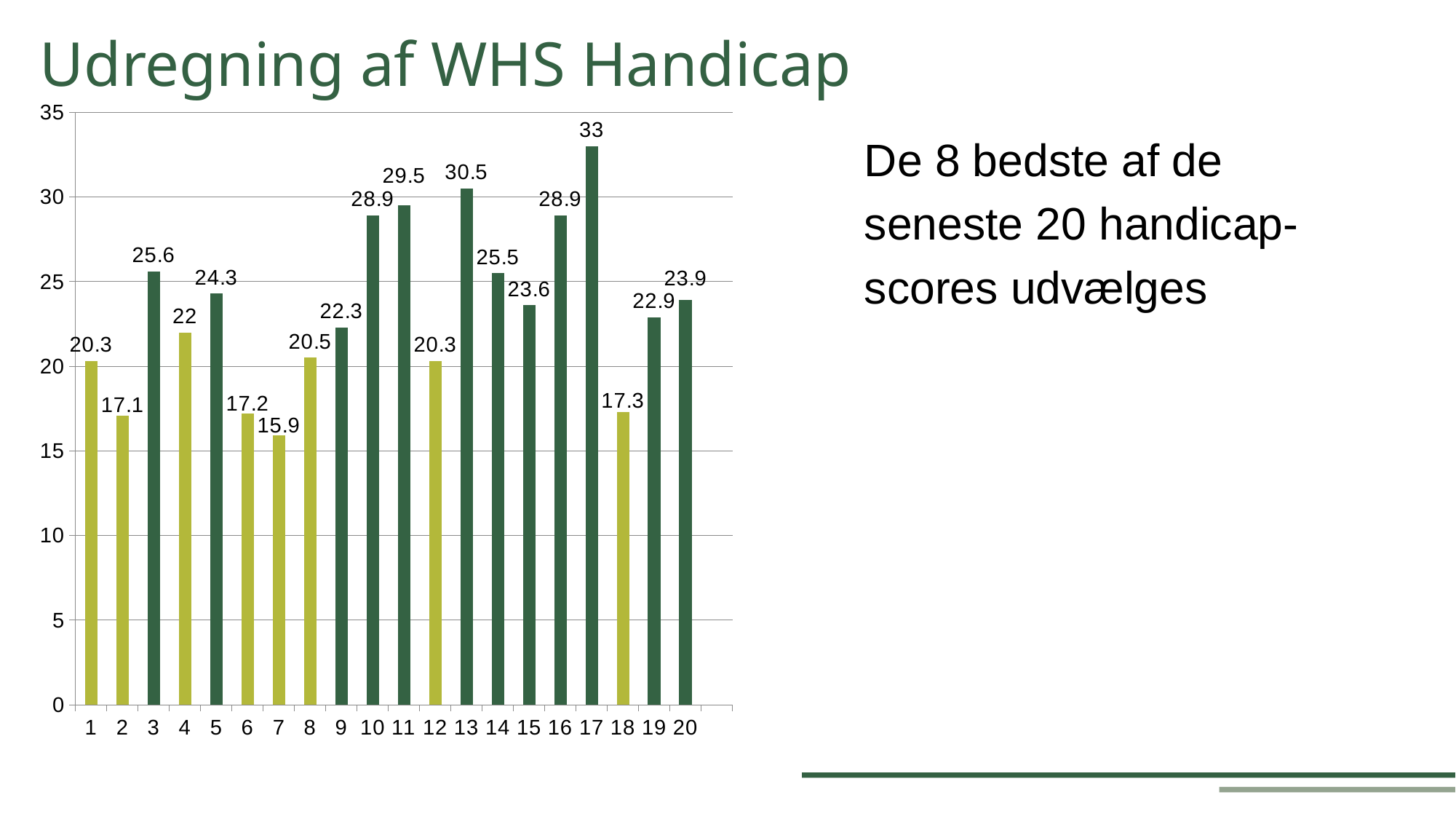
How many categories are shown on the x axis? 20 Is the value for category 9 greater or less than 25? less What is the value for category 7? 15.9 Which is larger, the value for category 13 or the value for category 10? 13 What is the value for category 17? 33 Which category has the highest value? 17 Which category has the lowest value? 7 What is the difference between the values for category 3 and category 4? 3.6 What is the value for category 11? 29.5 How many bars are coloured light green (yellow-green) rather than dark green? 8 What kind of chart is shown on the slide? bar chart What is the difference between the values for category 17 and category 7? 17.1